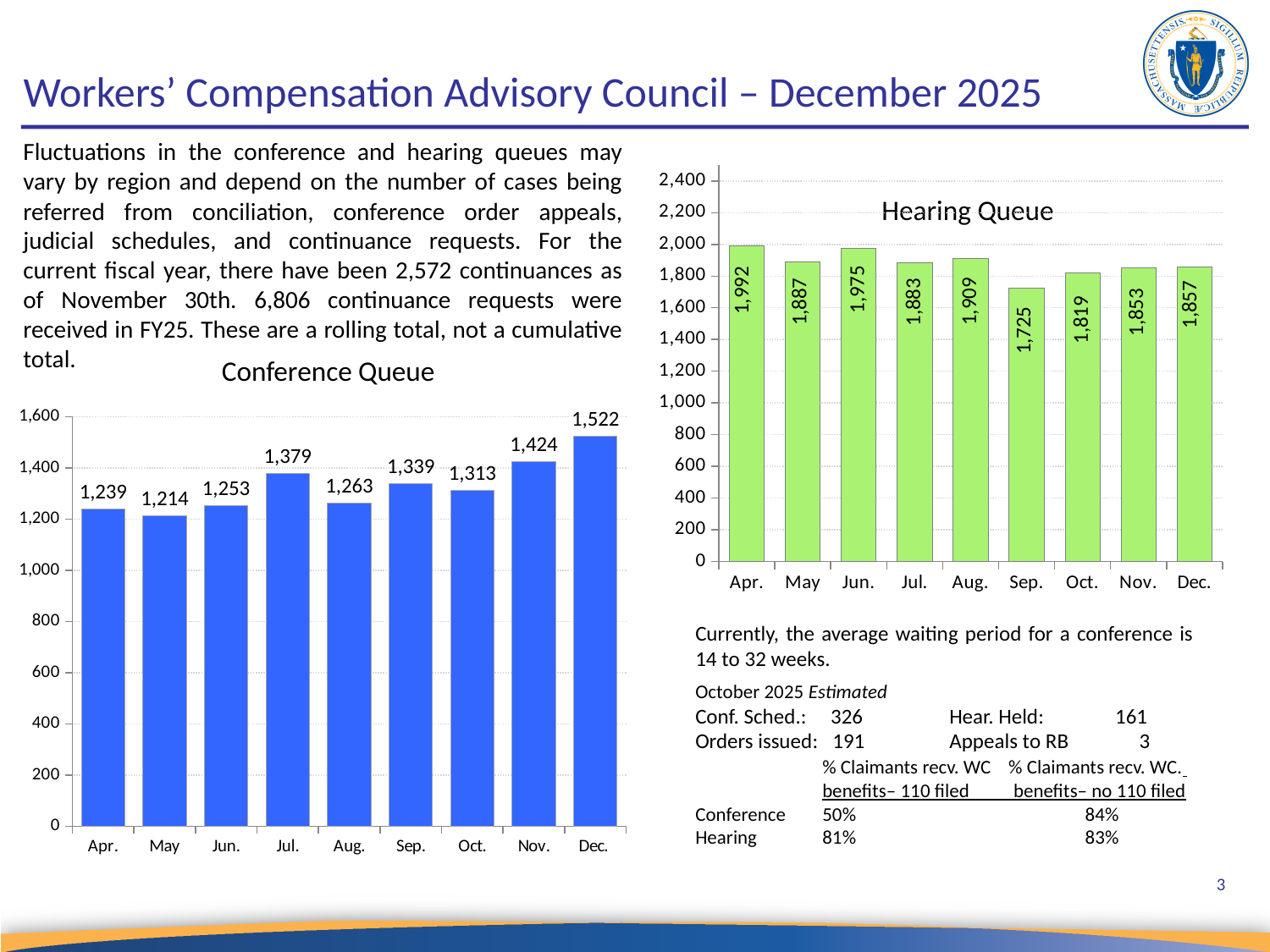
In the Hearing Queue chart, what is the difference between the values for Apr. and Sep.? 267 In the Conference Queue chart, which month has the highest value? Dec. In the Conference Queue chart, do the values rise or fall from Oct. to Dec.? Rise In the Conference Queue chart, which month has the lowest value? May In the Conference Queue chart, what is the value for Jul.? 1,379 How many months are shown in the Conference Queue chart? 9 What type of chart is the Hearing Queue chart? Bar chart In the Hearing Queue chart, which month has the highest value? Apr. In the Conference Queue chart, what is the difference between the values for Dec. and Apr.? 283 In the Hearing Queue chart, which is larger, the value for Jun. or the value for Aug.? Jun. In the Hearing Queue chart, what is the value for Sep.? 1,725 In the Hearing Queue chart, which month has the lowest value? Sep.